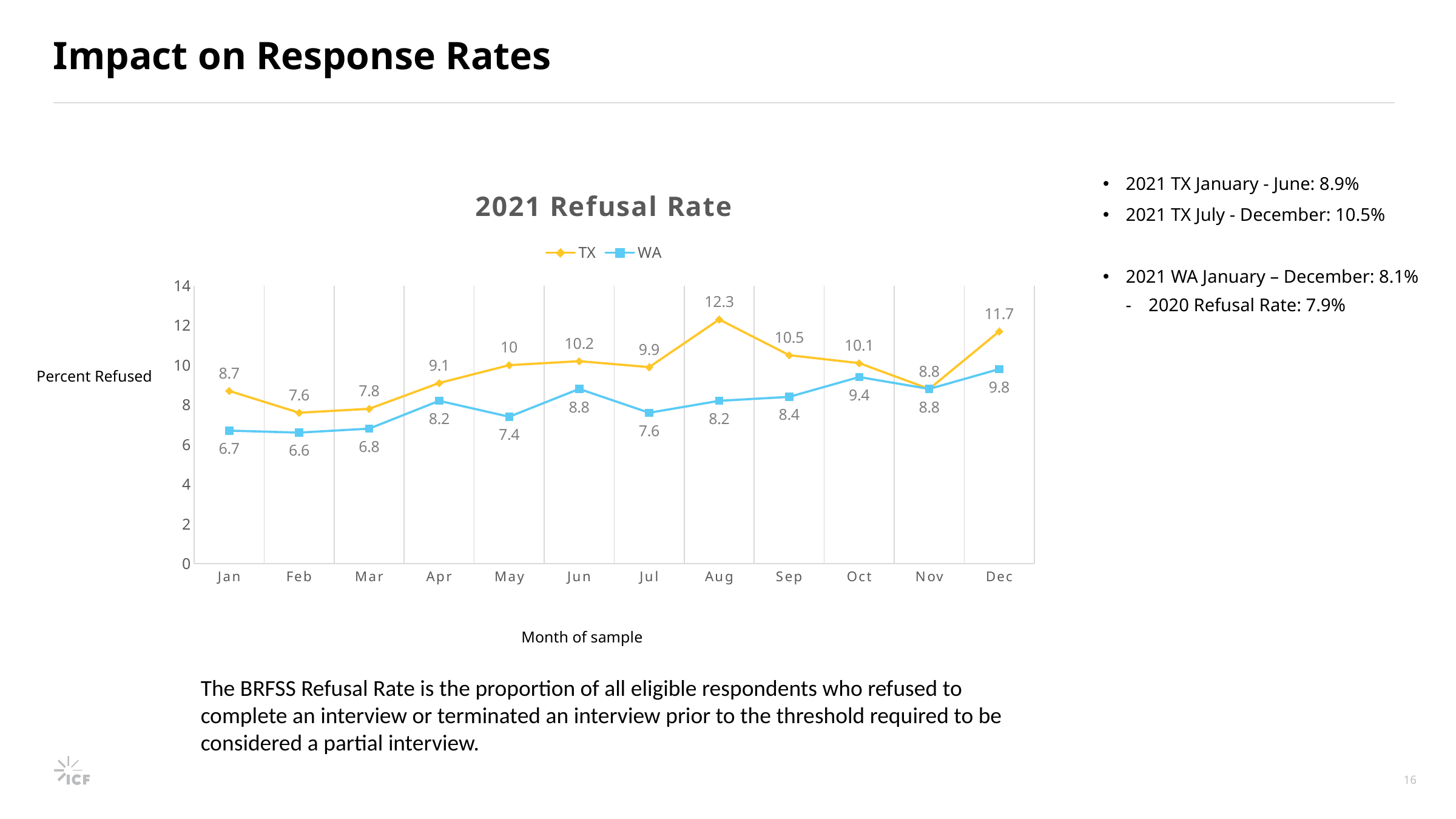
What is the difference between the TX and WA refusal rates in August? 4.1 In which month is the TX refusal rate highest? Aug What is the TX refusal rate for December? 11.7 How many series does the legend list? 2 What kind of chart is shown? Line chart What is the title of the chart? 2021 Refusal Rate What is the TX refusal rate for August? 12.3 Does the WA refusal rate rise or fall from September to October? Rise How many months are shown on the x axis? 12 Which series has the higher refusal rate in June, TX or WA? TX What is the WA refusal rate for May? 7.4 In which month is the WA refusal rate lowest? Feb